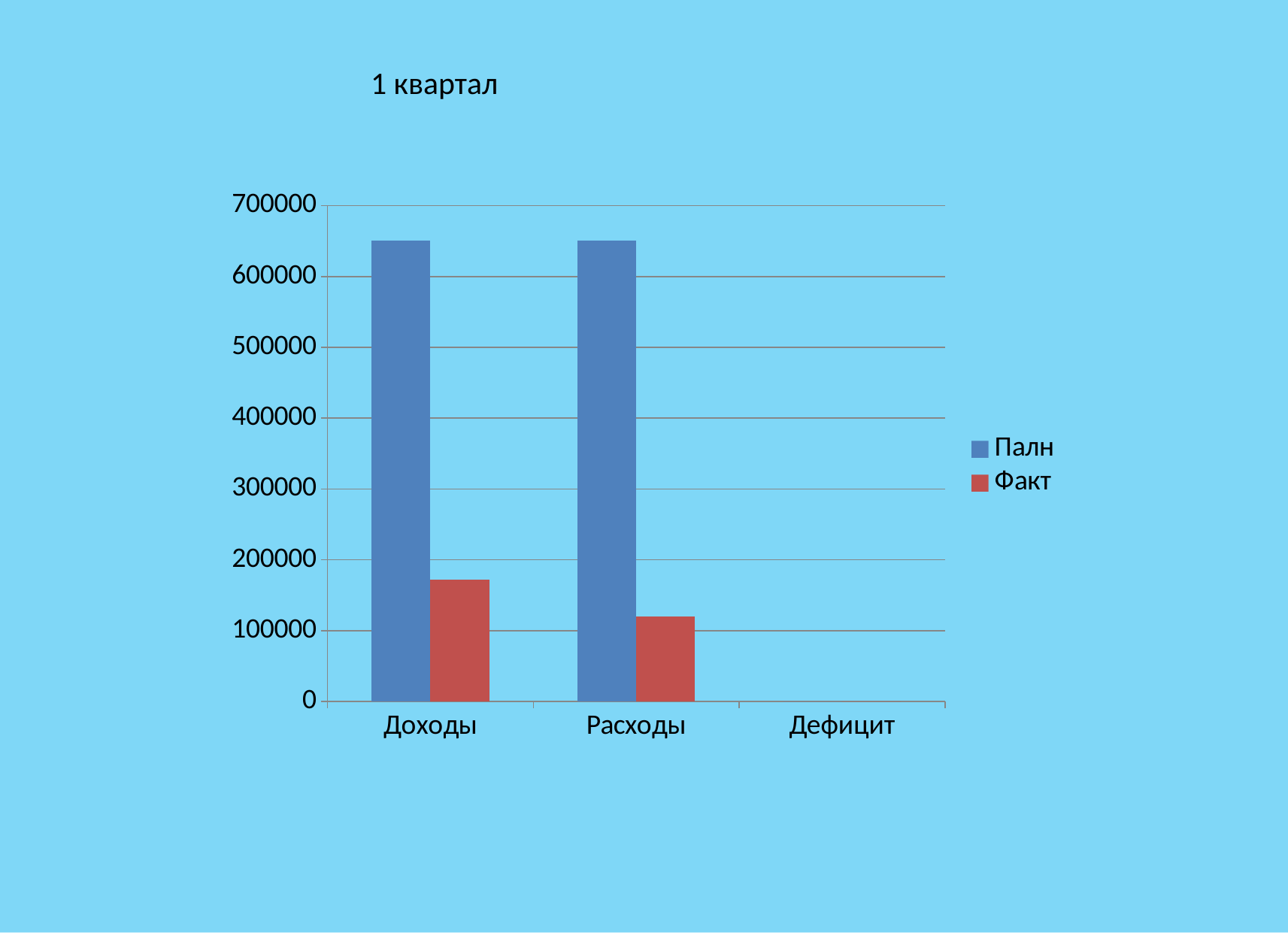
Is the Факт value for Расходы greater or less than 100000? greater What is the title of the chart? 1 квартал Is the Палн value for Доходы greater or less than 600000? greater For Доходы, which is larger: the Палн value or the Факт value? Палн Is the Палн value for Расходы greater or less than 700000? less How many series does the legend list? 2 Which category has the lowest Факт value? Дефицит Which series is shown in red in the legend? Факт What kind of chart is shown on the slide? bar chart For the Факт series, which is larger: Доходы or Расходы? Доходы How many categories are shown on the x axis? 3